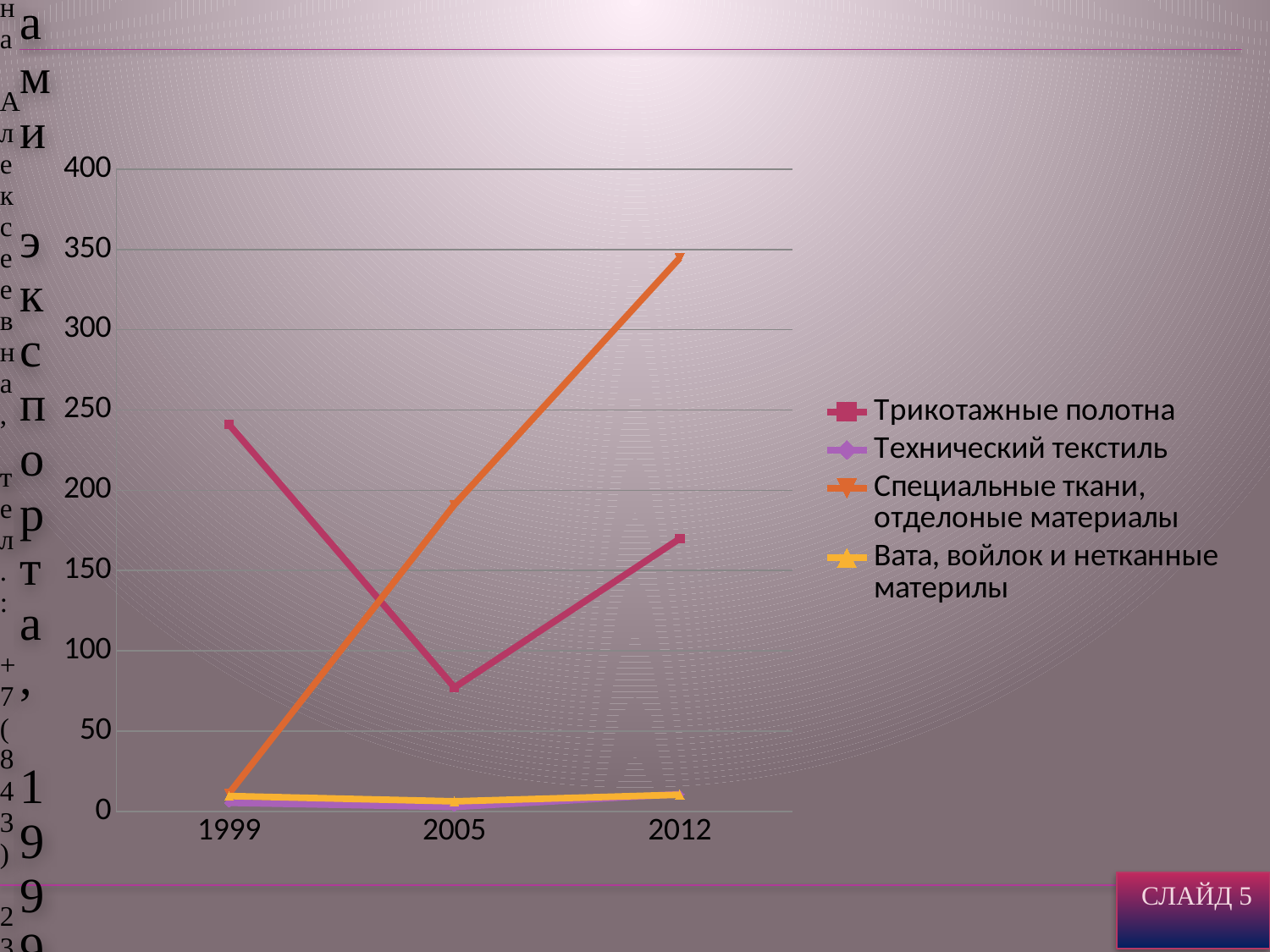
How many series does the legend list? 4 Is the value for Трикотажные полотна in 1999 greater or less than 200? greater What colour is the line for Специальные ткани, отделоные материалы? orange Do the values for Специальные ткани, отделоные материалы rise or fall from 1999 to 2012? rise In 2012, which is larger: Специальные ткани, отделоные материалы or Трикотажные полотна? Специальные ткани, отделоные материалы In 1999, which is larger: Трикотажные полотна or Специальные ткани, отделоные материалы? Трикотажные полотна Is the value for Специальные ткани, отделоные материалы in 1999 greater or less than 50? less In which year is the value for Трикотажные полотна highest? 1999 Is the value for Специальные ткани, отделоные материалы in 2012 greater or less than 300? greater What kind of chart is shown on the slide? line chart How many years are shown on the x axis? 3